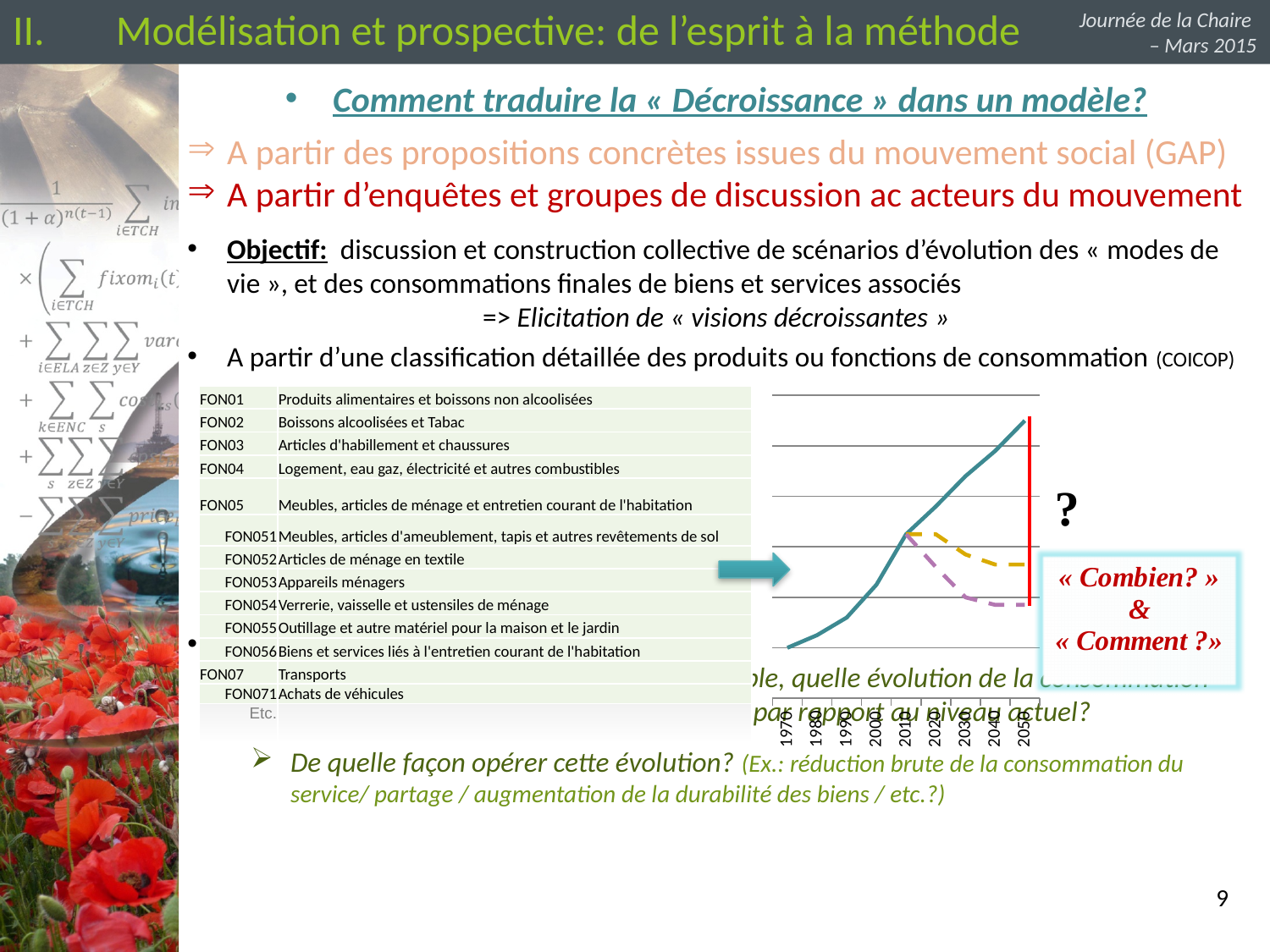
In the line chart, after the dashed lines branch off from the solid line, do the dashed lines rise or fall? fall What is the last year shown on the x axis of the line chart? 2050 What kind of chart is shown on the right of the slide, next to the COICOP table? line chart In the line chart, does the solid teal line rise or fall from left to right along the x axis? rise Does the line chart display a legend? No What is the first year shown on the x axis of the line chart? 1970 How many lines (solid and dashed) are plotted in the line chart? 3 What colour is the solid line in the line chart? teal How many dashed lines are plotted in the line chart? 2 In the line chart, which dashed line ends lower at the right-hand side, the yellow one or the purple one? purple What colours are the two dashed lines in the line chart? yellow and purple